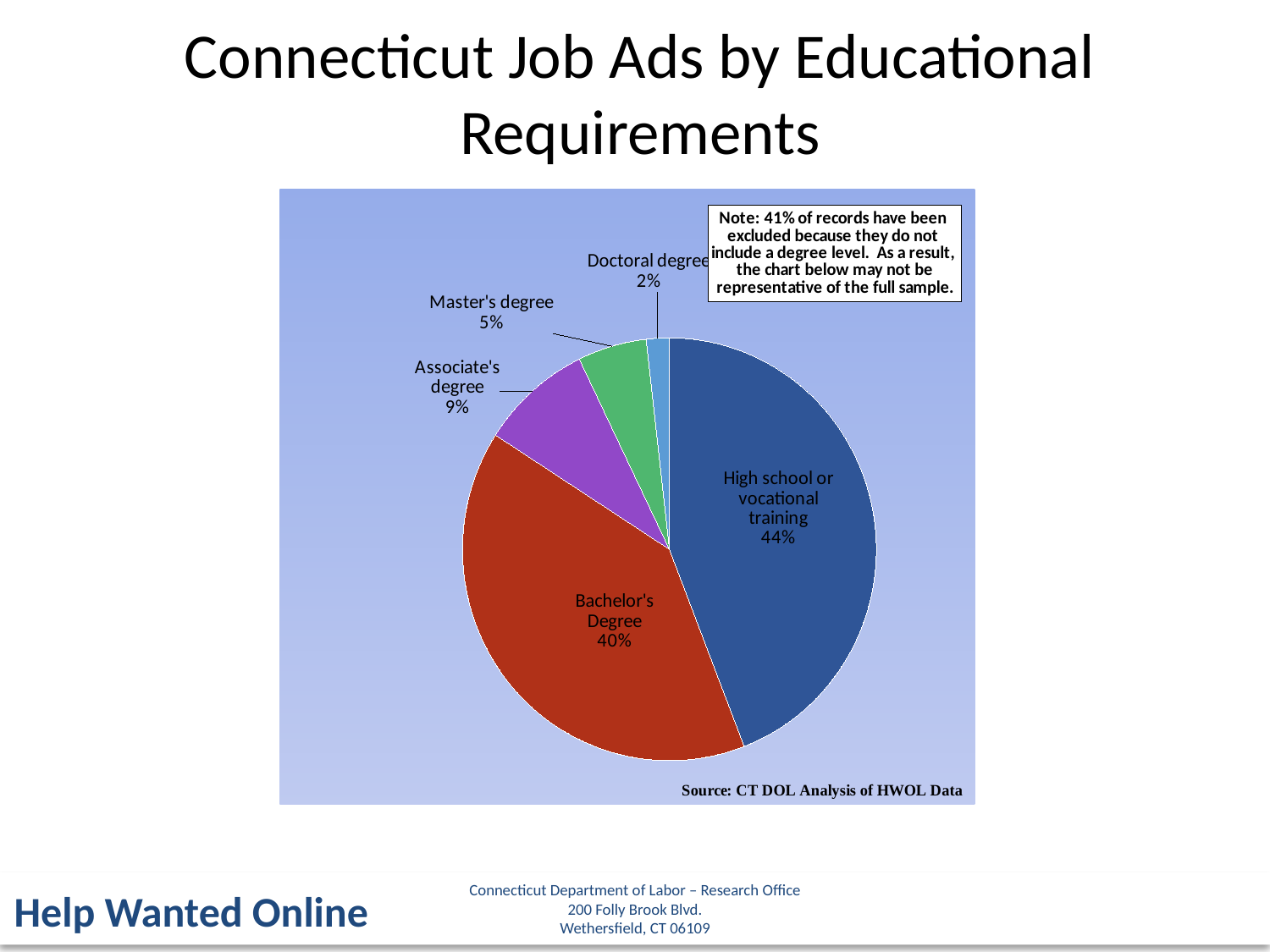
What share of job ads require a Bachelor's Degree? 40% Which educational requirement has the largest share of job ads? High school or vocational training Which educational requirement has the smallest share of job ads? Doctoral degree How many educational requirement categories are shown in the pie chart? 5 What is the difference in percentage points between the High school or vocational training share and the Bachelor's Degree share? 4 What type of chart is shown on the slide? Pie chart Which is larger: the share for Associate's degree or the share for Master's degree? Associate's degree What share of Connecticut job ads require a high school or vocational training? 44% What percentage of job ads require an Associate's degree? 9% What percentage of job ads require a Master's degree? 5% According to the note on the chart, what percentage of records were excluded because they do not include a degree level? 41% What percentage of job ads require a Doctoral degree? 2%